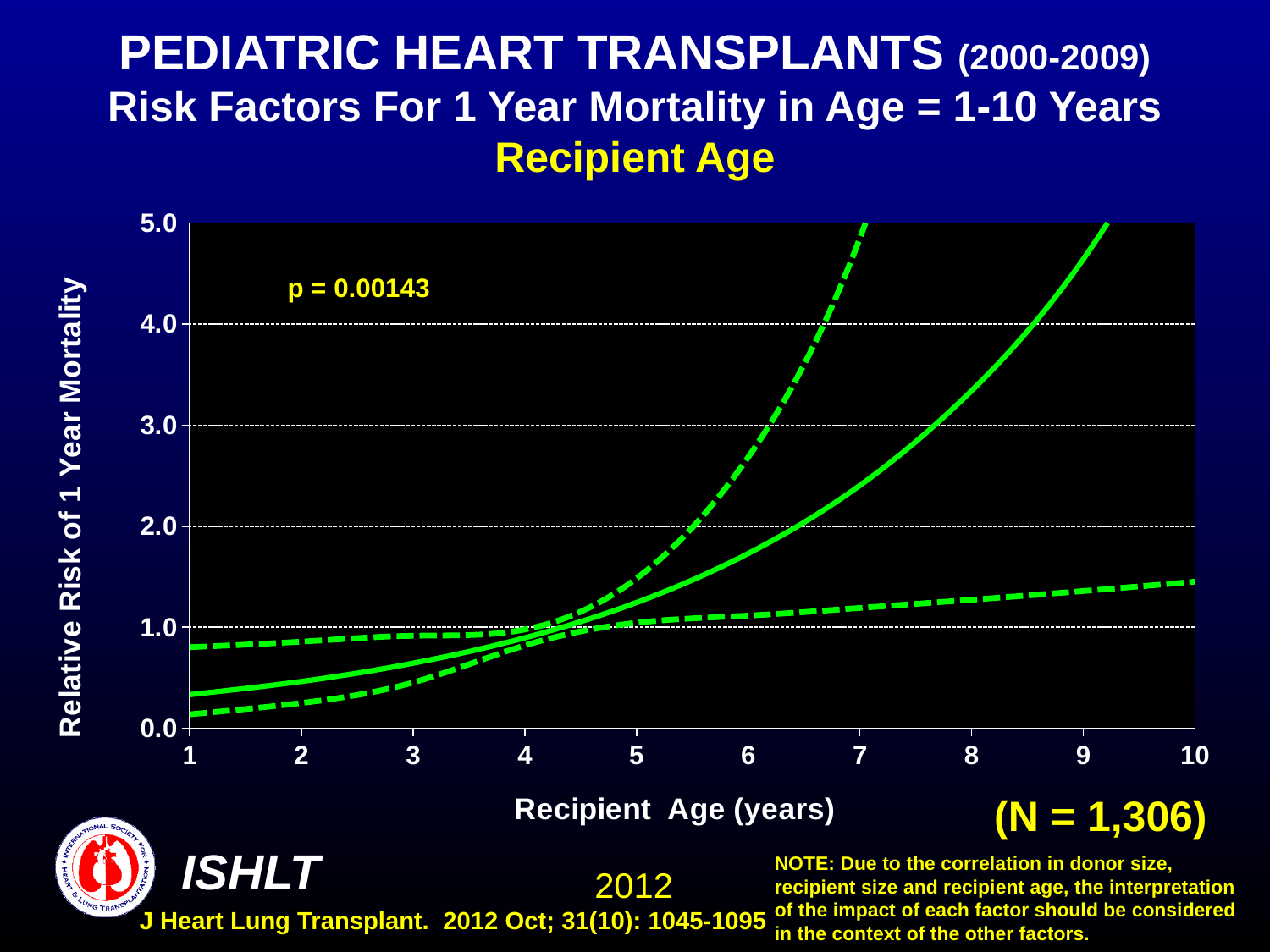
Is the relative risk shown by the solid line at recipient age 1 year greater or less than 1.0? less Is the relative risk shown by the solid line at recipient age 7 years greater or less than 2.0? greater Is the relative risk shown by the solid line at recipient age 9 years greater or less than 4.0? greater What kind of chart is shown on the slide? Line chart How many recipient age values are labelled on the x axis? 10 What p-value is printed on the chart? p = 0.00143 What is the maximum value shown on the y axis? 5.0 Does the solid line for relative risk of 1 year mortality rise or fall as recipient age increases from 1 to 10 years? Rises